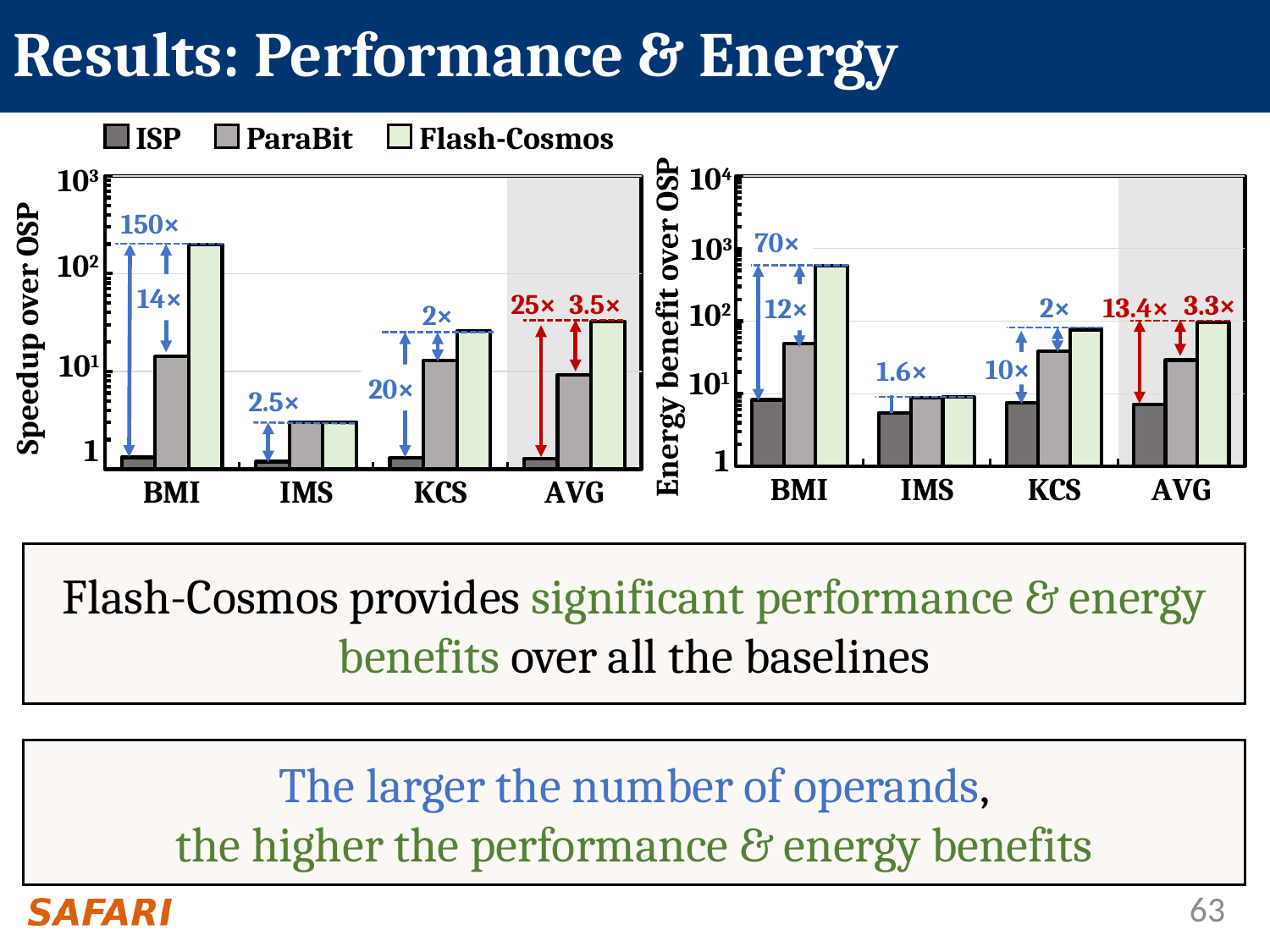
In the left chart (Speedup over OSP), which is larger for KCS: the ParaBit bar or the ISP bar? ParaBit In the left chart (Speedup over OSP), what annotated speedup does Flash-Cosmos achieve over ISP for BMI? 150× What is the y-axis label of the right chart? Energy benefit over OSP In the right chart (Energy benefit over OSP), which category has the lowest Flash-Cosmos bar? IMS In the left chart (Speedup over OSP), what annotated speedup does Flash-Cosmos achieve over ISP for AVG? 25× In the right chart (Energy benefit over OSP), what annotated energy benefit does Flash-Cosmos achieve over ParaBit for AVG? 3.3× In the left chart (Speedup over OSP), is the Flash-Cosmos value for BMI greater or less than 100? greater What kind of chart is the left chart titled "Speedup over OSP"? bar chart How many categories are shown on the x axis of the right chart (Energy benefit over OSP)? 4 How many series does the legend list for the charts? 3 In the left chart (Speedup over OSP), which category has the tallest Flash-Cosmos bar? BMI